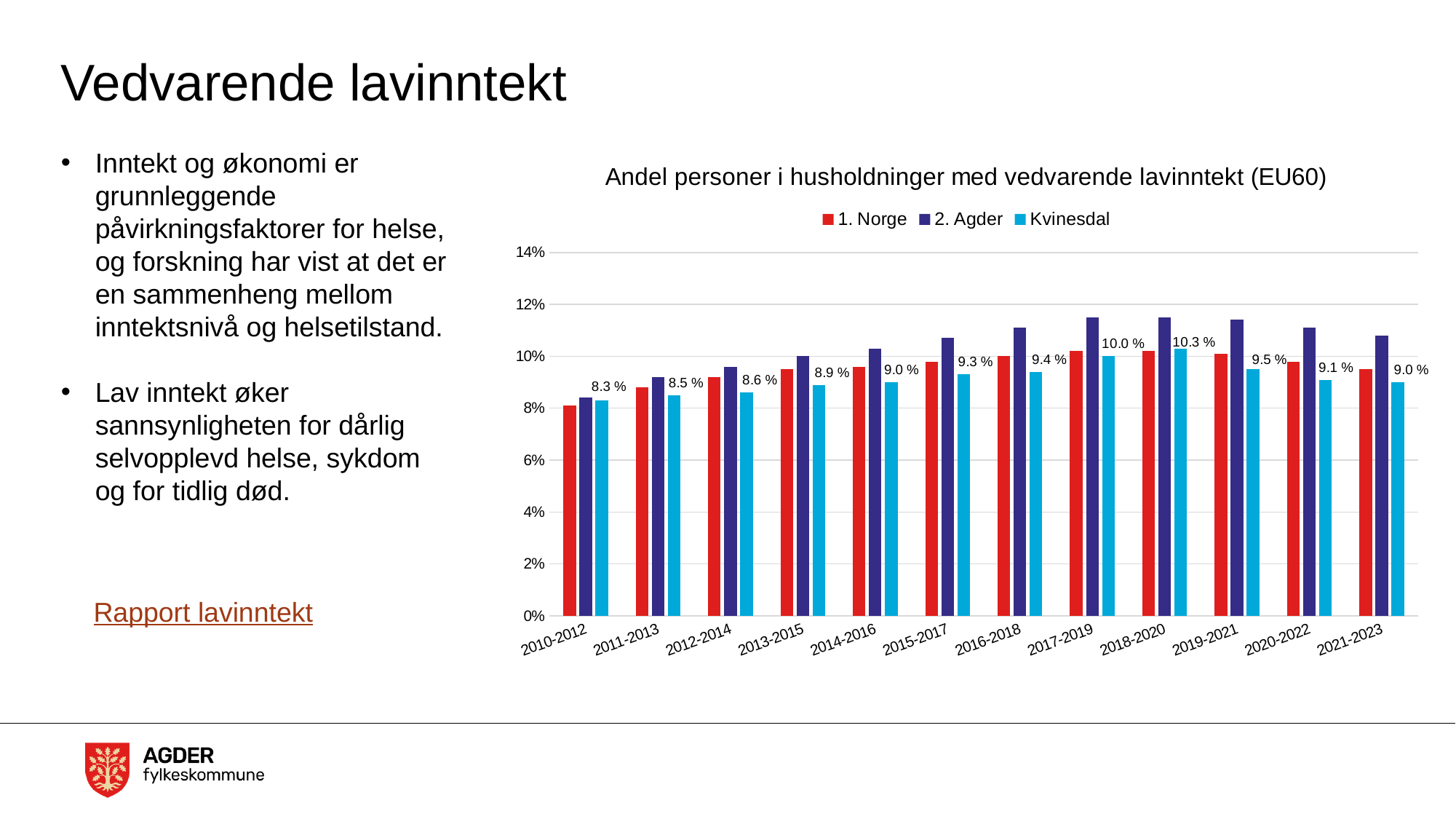
How many time periods are shown on the x axis? 12 What is the value for Kvinesdal in the 2018-2020 period? 10.3 % In which period is the Kvinesdal value lowest? 2010-2012 In which period is the Kvinesdal value highest? 2018-2020 Is the value for 1. Norge in 2010-2012 greater or less than 10%? less What is the value for Kvinesdal in the 2010-2012 period? 8.3 % What is the difference between the Kvinesdal value in 2018-2020 and in 2010-2012? 2.0 percentage points Is the value for 2. Agder in 2017-2019 greater or less than 10%? greater How many series does the legend list? 3 What kind of chart is shown on the slide? Bar chart What is the value for Kvinesdal in the 2021-2023 period? 9.0 % In the 2017-2019 period, which is larger: the value for 1. Norge or for 2. Agder? 2. Agder